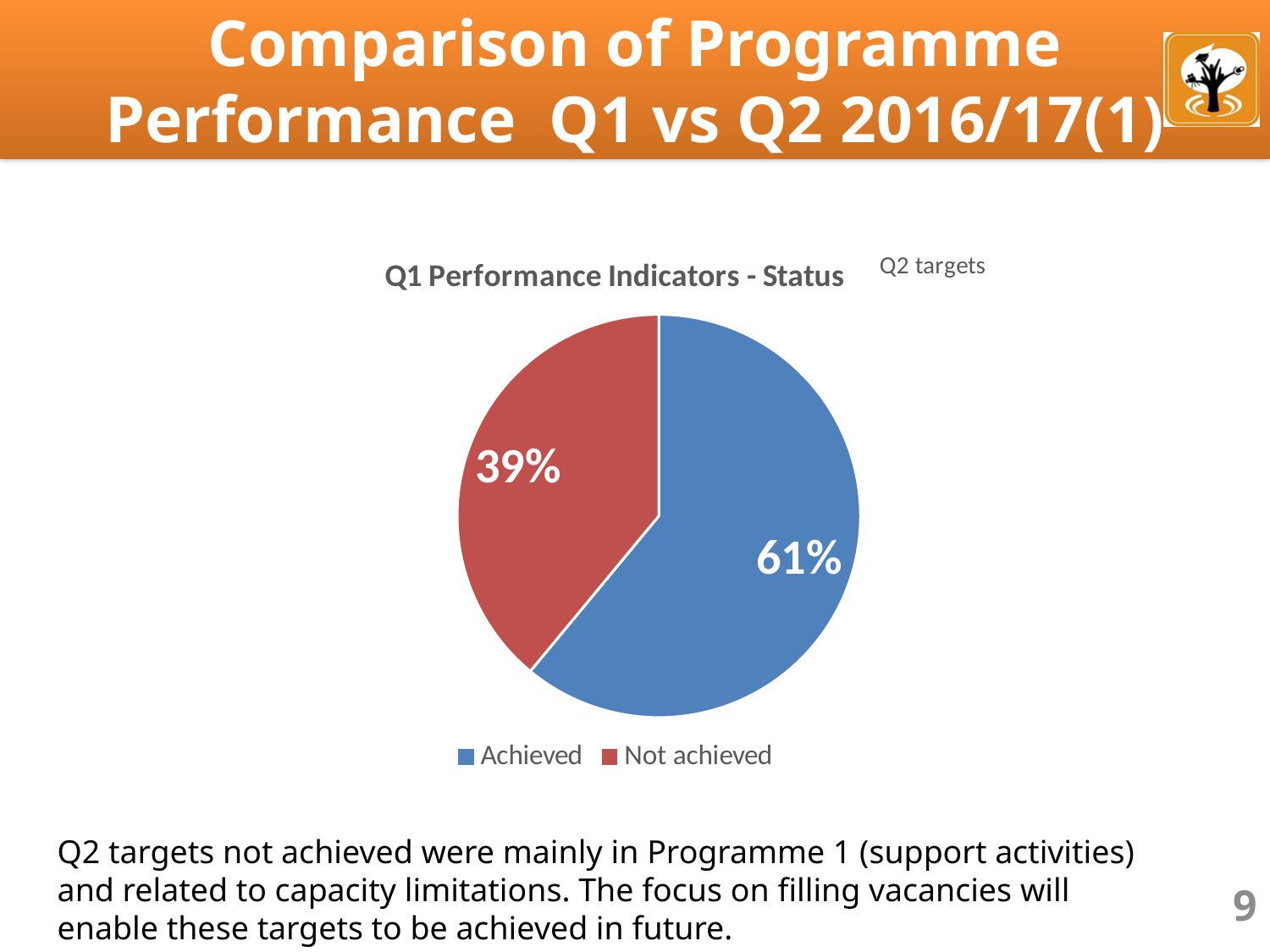
How many slices does the pie chart have? 2 What share of the pie does the Achieved slice represent? 61% Which category has the smallest share of the pie? Not achieved How many entries does the legend list? 2 Which slice of the pie is larger, Achieved or Not achieved? Achieved What colour is the Not achieved slice? red What kind of chart is shown on the slide? pie chart What is the difference in percentage points between the Achieved and Not achieved slices? 22 What is the title of the pie chart? Q1 Performance Indicators - Status What percentage of Q1 performance indicators were not achieved? 39% What percentage of Q1 performance indicators were achieved? 61% Which category has the largest share of the pie? Achieved